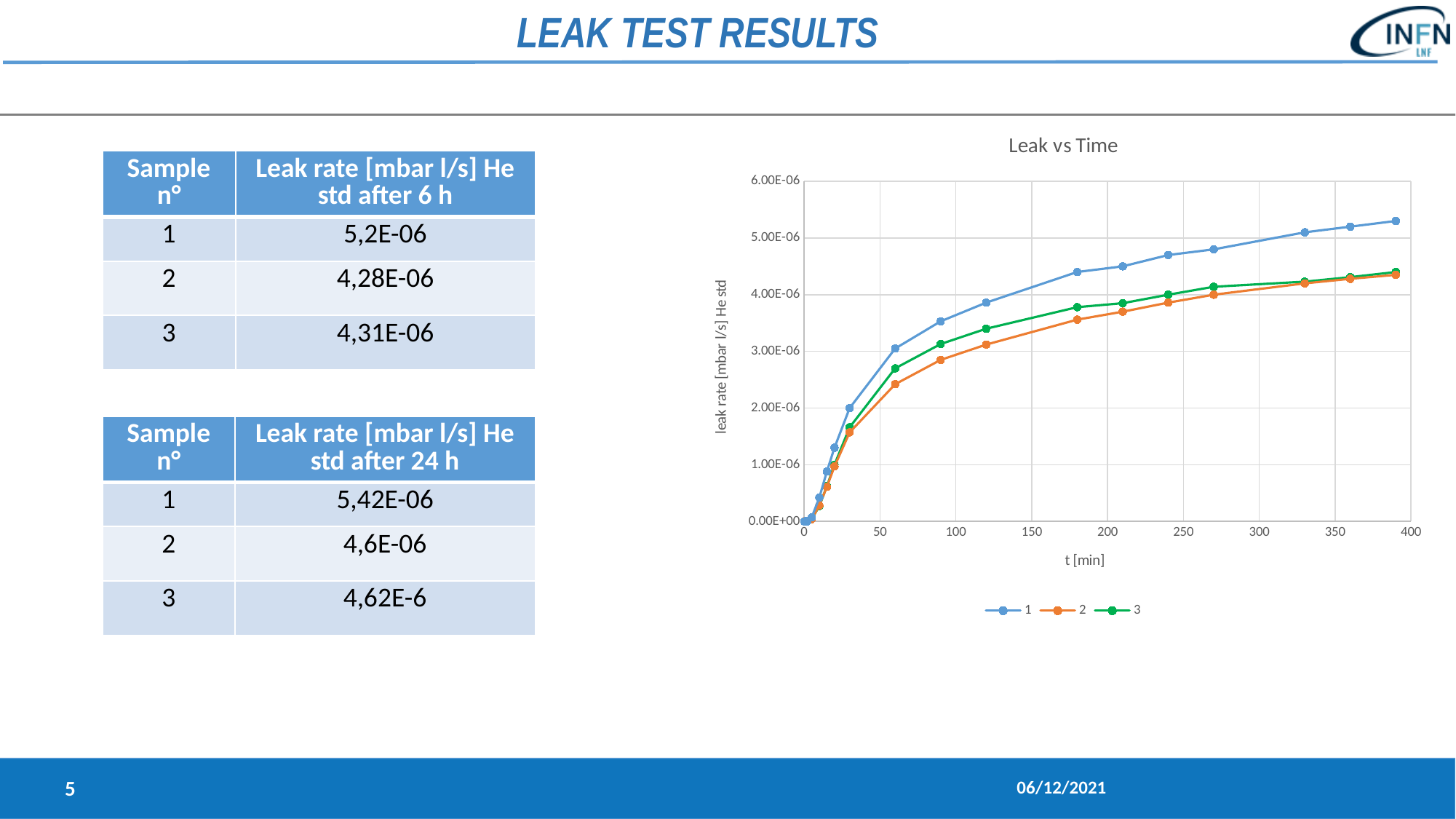
In the 'Leak vs Time' chart, do the values of series 1 rise or fall as time increases? rise What kind of chart is the 'Leak vs Time' chart? line chart What is the x-axis label of the 'Leak vs Time' chart? t [min] In the 'Leak vs Time' chart, is the value of series 2 at 60 min greater or less than 2.00E-06? greater In the 'Leak vs Time' chart, is the value of series 1 at 390 min greater or less than 5.00E-06? greater How many series does the legend of the 'Leak vs Time' chart list? 3 In the 'Leak vs Time' chart, is the value of series 3 at 180 min greater or less than 4.00E-06? less In the 'Leak vs Time' chart, which series has the lowest leak rate at 120 min? 2 In the 'Leak vs Time' chart, which series has the highest leak rate at 390 min? 1 In the 'Leak vs Time' chart, which is larger at 120 min: the value of series 1 or series 2? series 1 What is the title of the chart on the slide? Leak vs Time